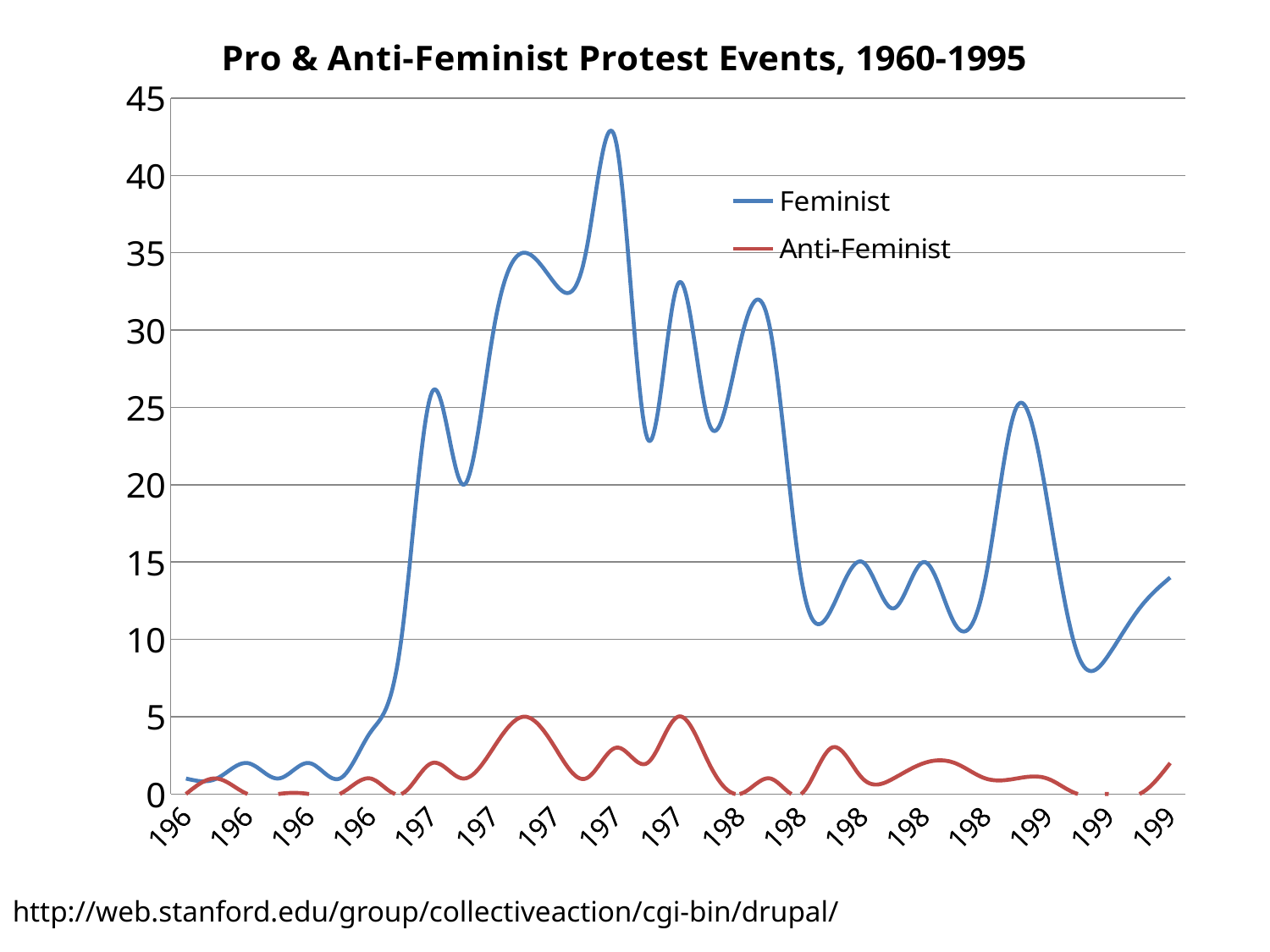
Which series has the larger values across the chart, Feminist or Anti-Feminist? Feminist What is the highest value shown on the vertical axis? 45 What kind of chart is shown on the slide? Line chart Is the value of the Feminist series at the end of the chart greater or less than 10? greater Is the peak value of the Feminist series greater or less than 45? less Is the peak value of the Anti-Feminist series greater or less than 10? less Which series is drawn in red? Anti-Feminist Which series reaches the highest value on the chart? Feminist What is the title of the chart? Pro & Anti-Feminist Protest Events, 1960-1995 How many series does the legend list? 2